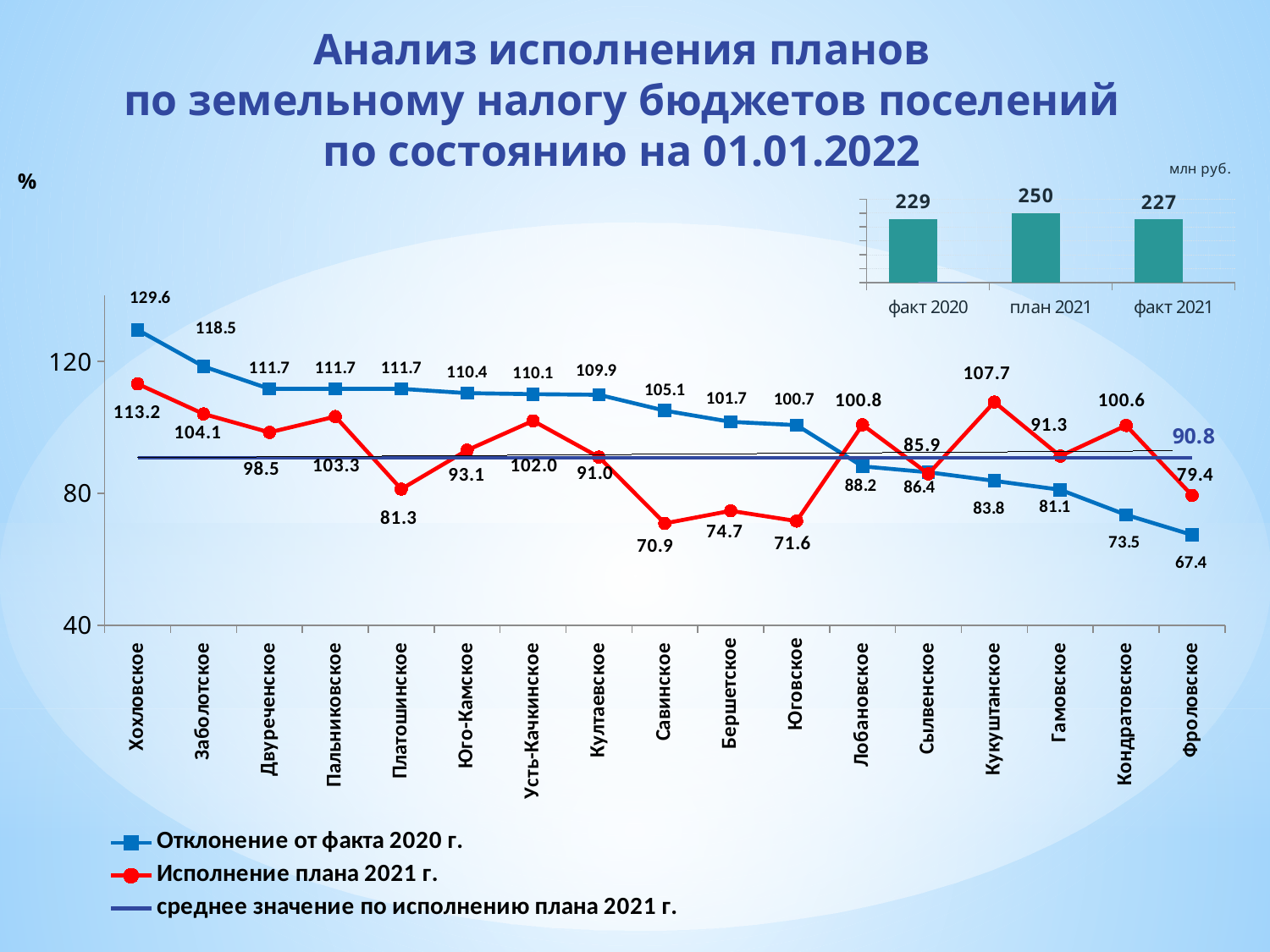
In the small bar chart at the top right, what is the value for план 2021? 250 In the small bar chart at the top right, which category has the highest value? план 2021 How many settlements are shown on the x axis of the main line chart? 17 In the main line chart, which settlement has the highest value for Исполнение плана 2021 г.? Хохловское In the small bar chart at the top right, what is the difference between факт 2020 and факт 2021? 2 In the main line chart, does the Отклонение от факта 2020 г. series rise or fall from left to right? fall How many series does the legend of the main line chart list? 3 In the main line chart, for Кукуштанское, which is larger: Исполнение плана 2021 г. or Отклонение от факта 2020 г.? Исполнение плана 2021 г. In the main line chart, which settlement has the lowest value for Исполнение плана 2021 г.? Савинское In the main line chart, what is the value of Исполнение плана 2021 г. for Платошинское? 81.3 In the main line chart, what is the value of Отклонение от факта 2020 г. for Хохловское? 129.6 What kind of chart is the small chart at the top right of the slide? bar chart